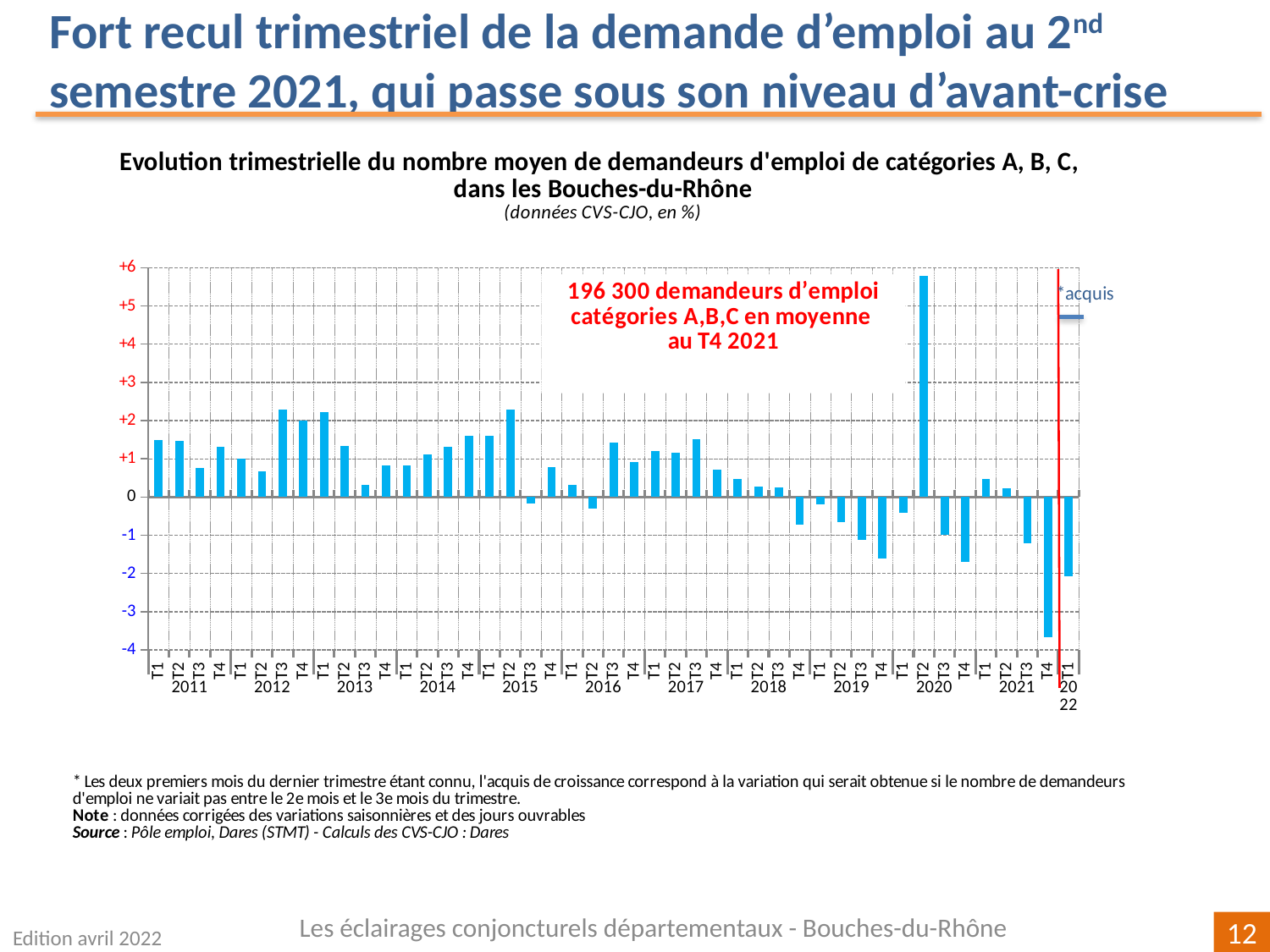
What is the unit indicated in the chart subtitle? % Which is larger, the value for T3 2012 or the value for T3 2013? T3 2012 Is the value for T4 2021 greater or less than -3? less What kind of chart is shown on the slide? bar chart Is the value for T1 2022 greater or less than -1? less Is the value for T4 2019 greater or less than -1? less According to the annotation on the chart, how many demandeurs d'emploi catégories A,B,C were there on average in T4 2021? 196 300 How many years are labelled on the x axis of the chart? 12 Which quarter has the highest value on the chart? T2 2020 Which quarter has the lowest value on the chart? T4 2021